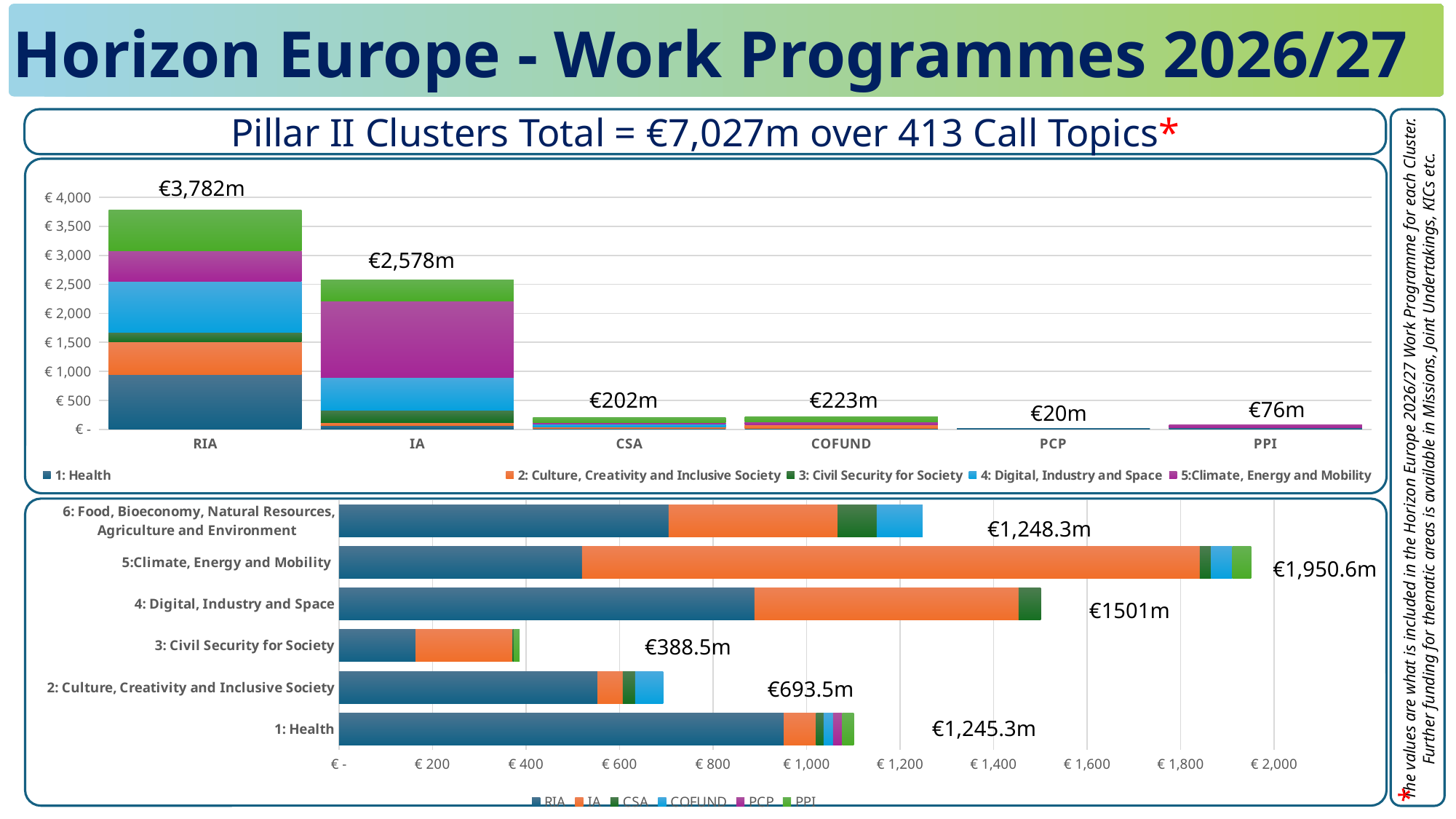
In the bottom chart, which cluster has the lowest total? 3: Civil Security for Society How many instrument types are shown on the x axis of the top chart? 6 How many series does the legend of the bottom chart list? 6 In the top chart, which is larger, the total for COFUND or the total for CSA? COFUND In the top chart, what is the difference between the RIA total and the IA total? €1,204m In the bottom chart, what is the total value labelled for 5: Climate, Energy and Mobility? €1,950.6m In the bottom chart, which cluster has the highest total? 5: Climate, Energy and Mobility In the top chart, what is the total value labelled for RIA? €3,782m In the bottom chart, what is the difference between the total for 5: Climate, Energy and Mobility and the total for 4: Digital, Industry and Space? €449.6m In the top chart, which instrument type has the highest total? RIA What kind of chart is the top chart? Stacked bar chart In the top chart, which instrument type has the lowest total? PCP